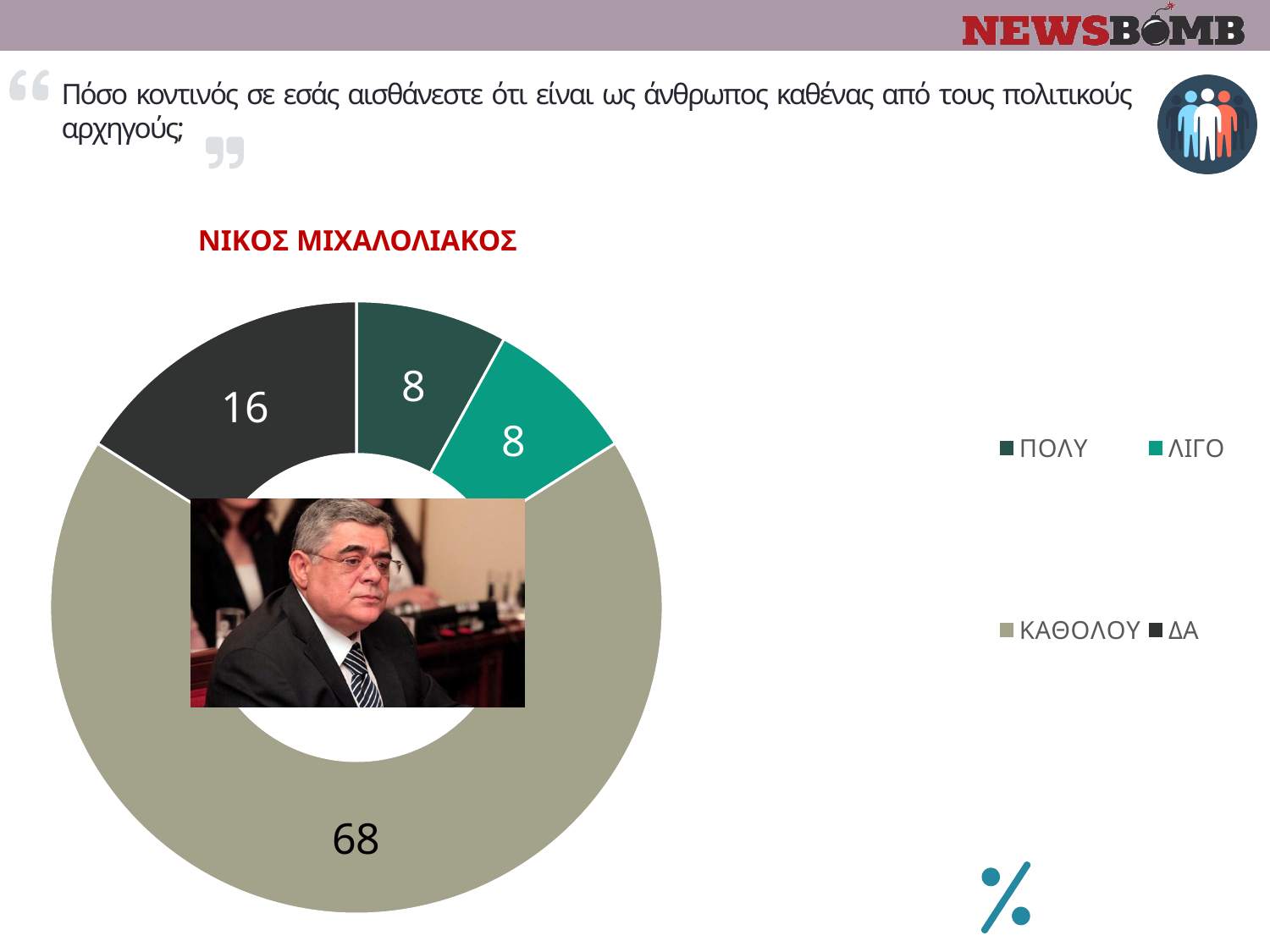
Which is larger, the value for ΔΑ or the value for ΛΙΓΟ? ΔΑ What is the value for ΛΙΓΟ in the chart? 8 What is the difference between the values for ΚΑΘΟΛΟΥ and ΔΑ? 52 What is the value for ΚΑΘΟΛΟΥ in the chart? 68 What is the value for ΔΑ in the chart? 16 Which category has the largest value in the chart? ΚΑΘΟΛΟΥ What kind of chart is shown on the slide? Doughnut chart What is the total of all the values shown in the chart? 100 What is the value for ΠΟΛΥ in the chart? 8 Which politician's name is shown as the title above the chart? ΝΙΚΟΣ ΜΙΧΑΛΟΛΙΑΚΟΣ How many categories does the legend of the chart list? 4 What is the difference between the values for ΔΑ and ΠΟΛΥ? 8